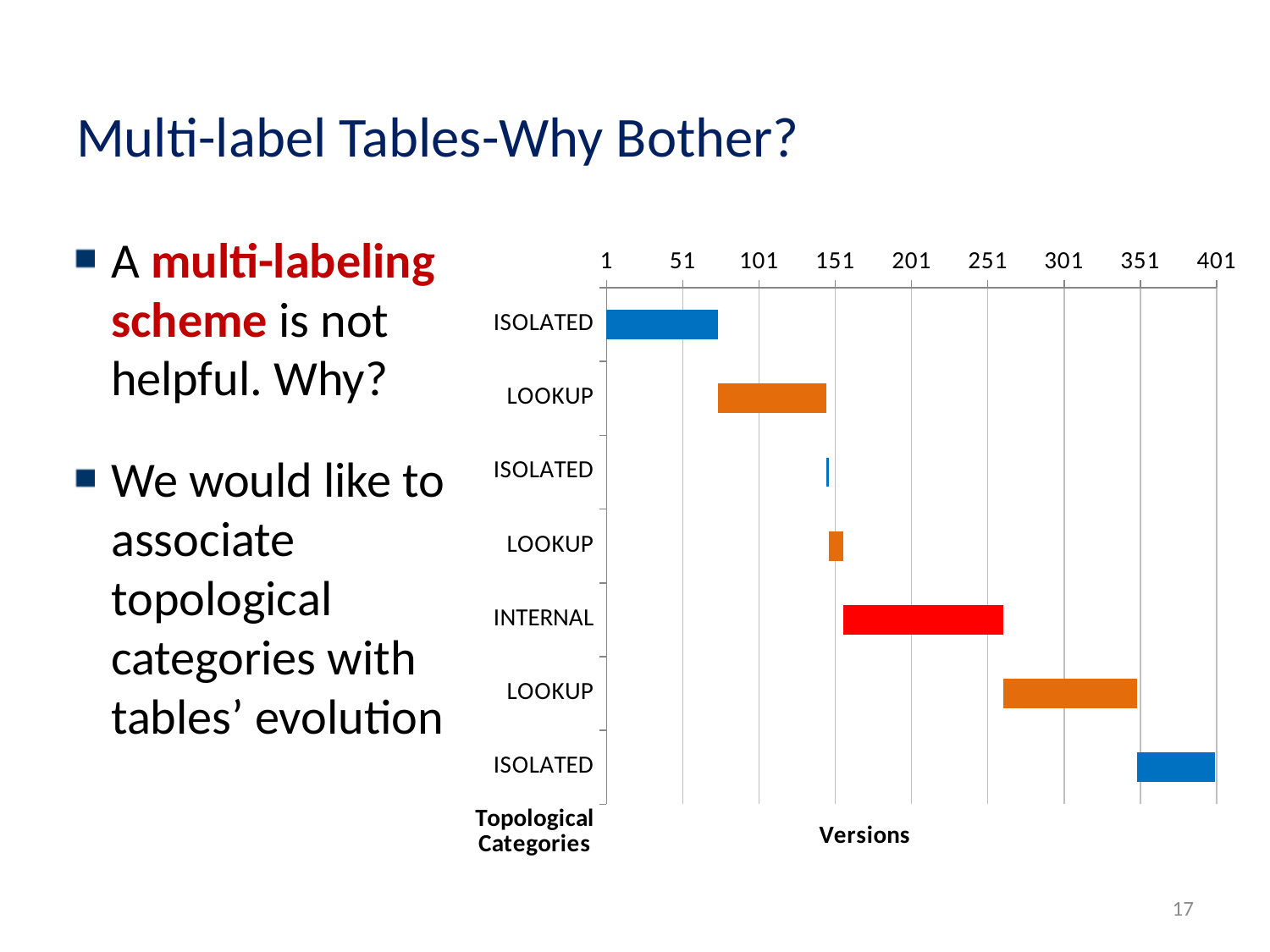
How many rows on the chart are labelled LOOKUP? 3 Is the end of the INTERNAL bar greater or less than 301 on the Versions axis? less What colour is the INTERNAL bar in the chart? red What is the title of the horizontal axis of the chart? Versions Which bar spans more versions: the INTERNAL bar or the top-row ISOLATED bar? INTERNAL How many category rows are listed on the vertical axis of the chart? 7 What kind of chart is shown on the slide? bar chart How many rows on the chart are labelled ISOLATED? 3 Which category has the longest bar in the chart? INTERNAL Is the end of the first ISOLATED bar (top row) greater or less than 101 on the Versions axis? less Is the start of the INTERNAL bar greater or less than 151 on the Versions axis? greater Which row has the shortest bar in the chart? the third row, ISOLATED